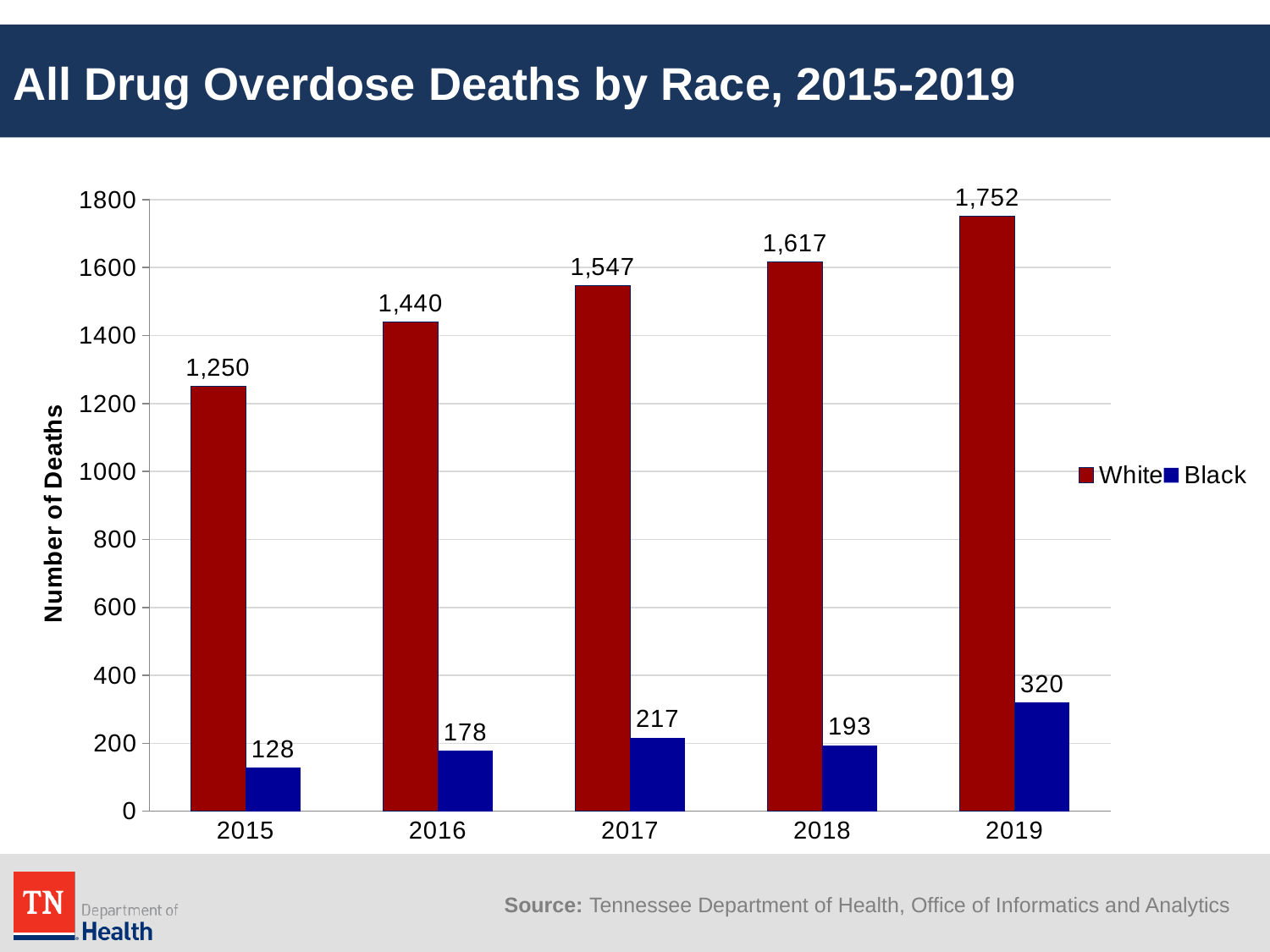
How many series does the legend list? 2 What is the number of drug overdose deaths for White in 2017? 1,547 In which year is the number of deaths for Black lowest? 2015 What is the number of drug overdose deaths for Black in 2018? 193 What kind of chart is shown on the slide? Bar chart Which is larger: Black deaths in 2017 or Black deaths in 2018? Black deaths in 2017 Do the values for White rise or fall from 2015 to 2019? Rise How many years are shown on the x axis? 5 What is the difference between White deaths in 2019 and White deaths in 2015? 502 What is the difference between Black deaths in 2019 and Black deaths in 2018? 127 In which year is the number of deaths for White highest? 2019 Is the value for White in 2016 greater or less than 1400? greater